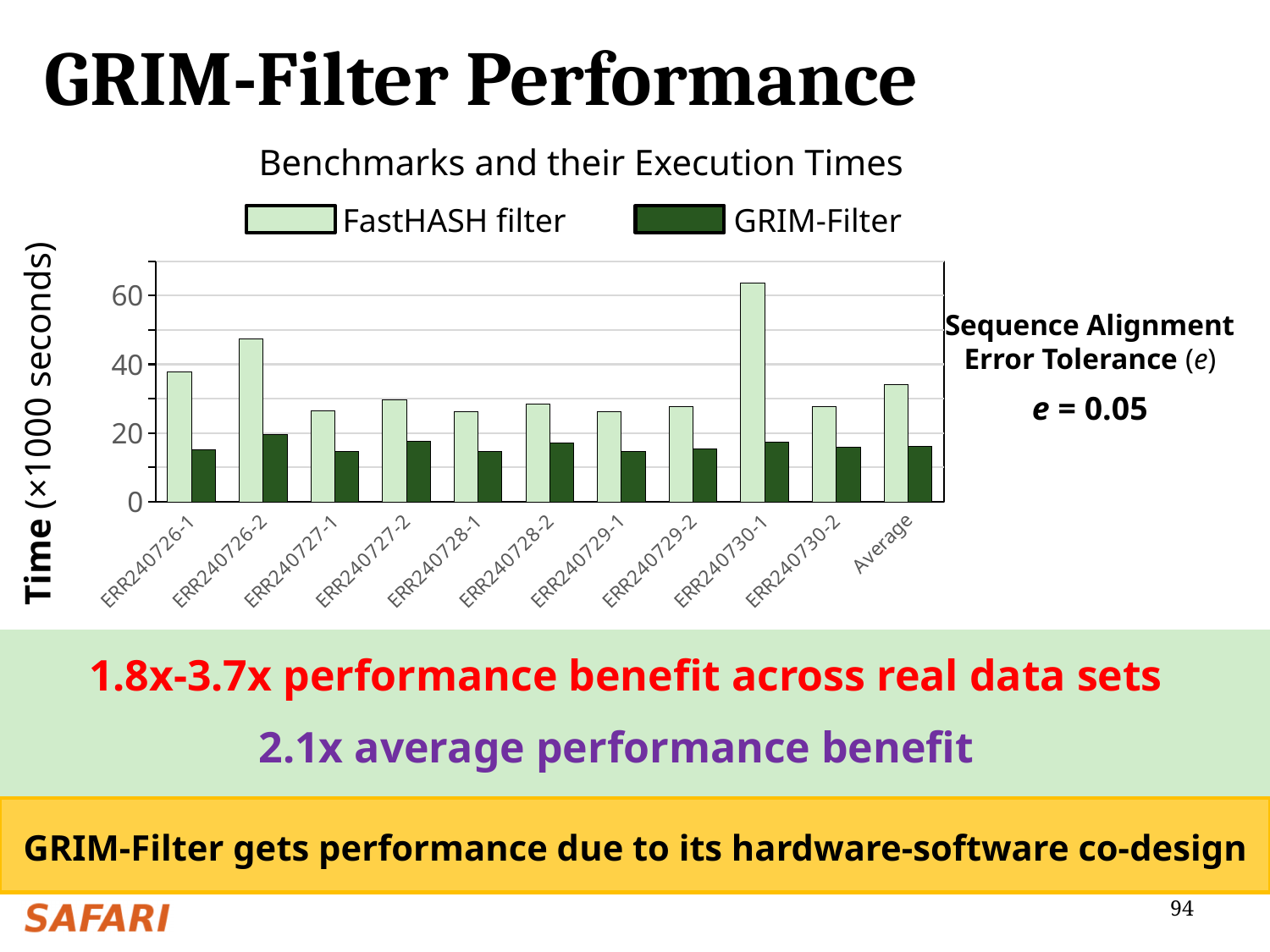
Is the FastHASH filter value for ERR240727-1 greater or less than 20? greater Is the FastHASH filter value for ERR240726-2 greater or less than 40? greater What is the label of the chart's y axis? Time (×1000 seconds) How many series does the chart legend list? 2 What is the title of the chart? Benchmarks and their Execution Times Is the FastHASH filter value for ERR240730-1 greater or less than 60? greater Which is larger: the FastHASH filter value for ERR240730-1 or the FastHASH filter value for ERR240730-2? ERR240730-1 For the Average category, which series has the larger value, FastHASH filter or GRIM-Filter? FastHASH filter What kind of chart is shown on the slide? bar chart How many categories are shown along the x axis of the chart? 11 Which category has the highest FastHASH filter value? ERR240730-1